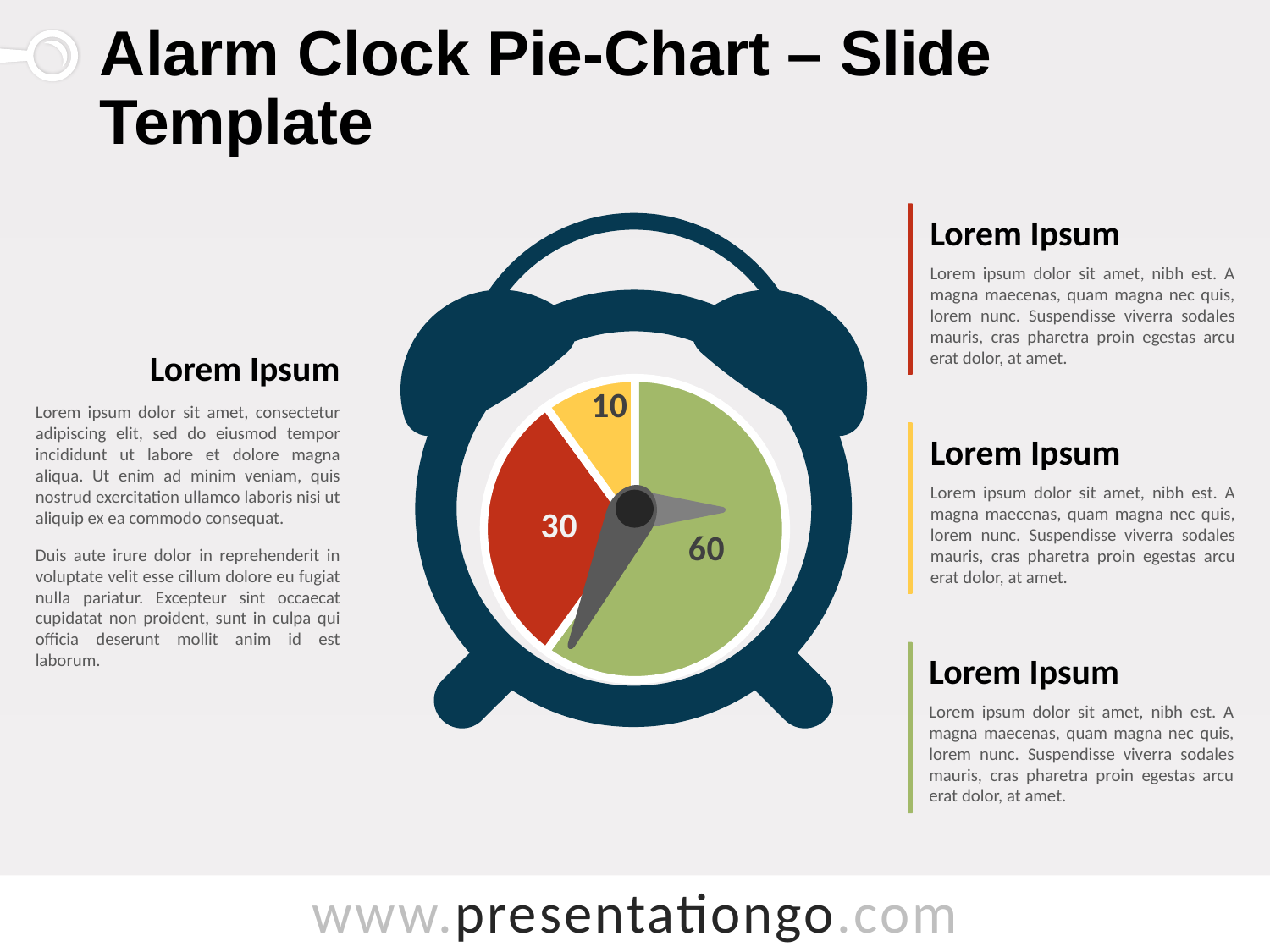
What is the difference between the red slice's value and the yellow slice's value? 20 Which slice of the pie chart has the smallest value? the yellow slice (10) What value is printed on the red slice of the pie chart? 30 How many slices does the pie chart have? 3 What kind of chart is shown inside the alarm clock? pie chart What value is printed on the green slice of the pie chart? 60 What is the total of the three values shown on the pie chart? 100 What is the difference between the green slice's value and the red slice's value? 30 Which slice of the pie chart has the largest value? the green slice (60) Which is larger, the red slice's value or the yellow slice's value? the red slice What value is printed on the yellow slice of the pie chart? 10 What share of the pie does the green slice represent? 60%